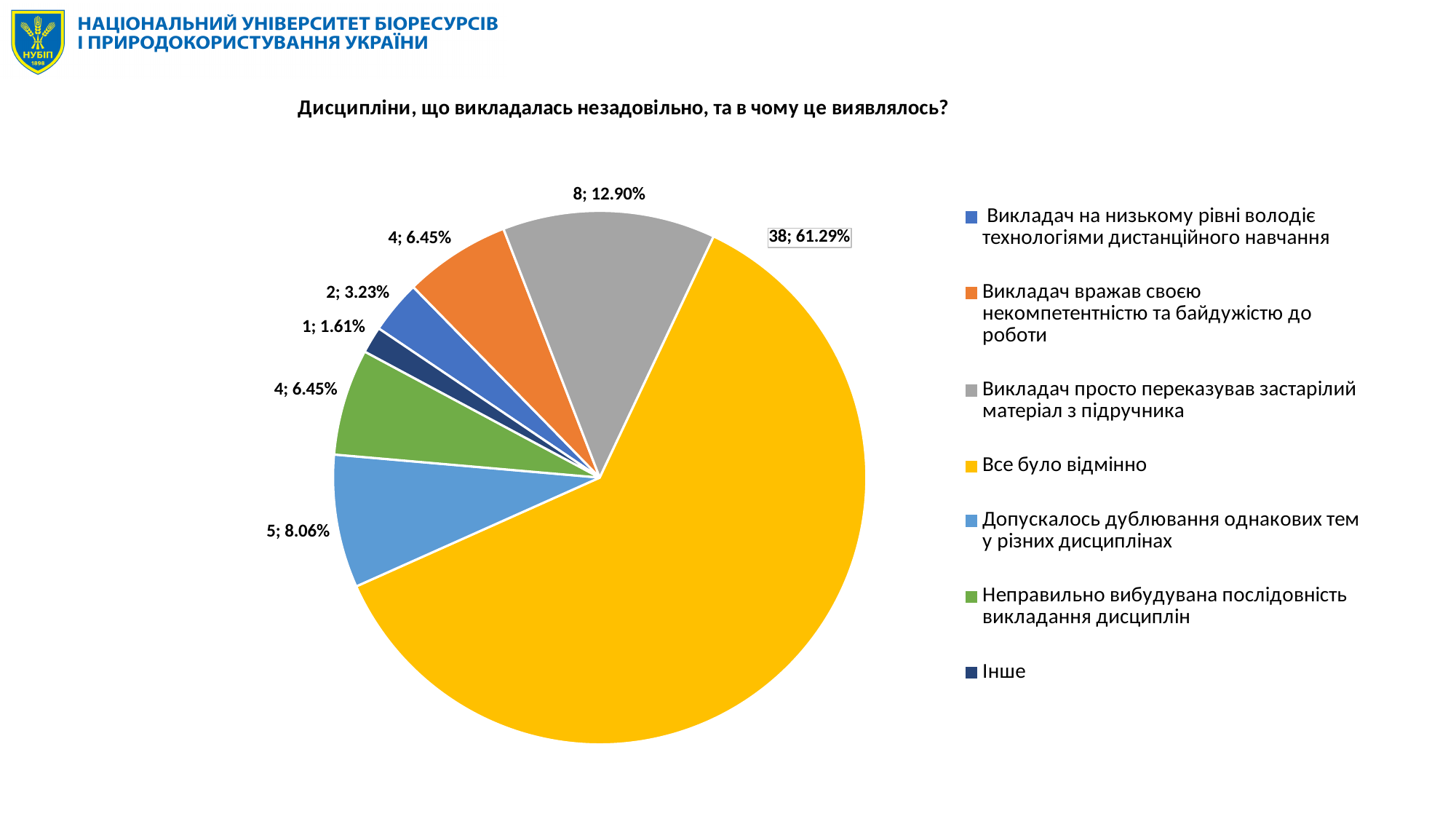
What share of the pie does "Все було відмінно" take? 61.29% What is the title of the chart? Дисципліни, що викладалась незадовільно, та в чому це виявлялось? How many slices does the pie chart have? 7 Which category has the largest slice? Все було відмінно Which is larger: the slice for "Допускалось дублювання однакових тем у різних дисциплінах" or the slice for "Викладач на низькому рівні володіє технологіями дистанційного навчання"? Допускалось дублювання однакових тем у різних дисциплінах What share of the pie does "Викладач просто переказував застарілий матеріал з підручника" take? 12.90% What kind of chart is shown on the slide? pie chart How many entries does the legend list? 7 What is the count for "Все було відмінно"? 38 What is the difference in count between "Все було відмінно" and "Викладач просто переказував застарілий матеріал з підручника"? 30 Which category has the smallest slice? Інше What is the count for "Допускалось дублювання однакових тем у різних дисциплінах"? 5